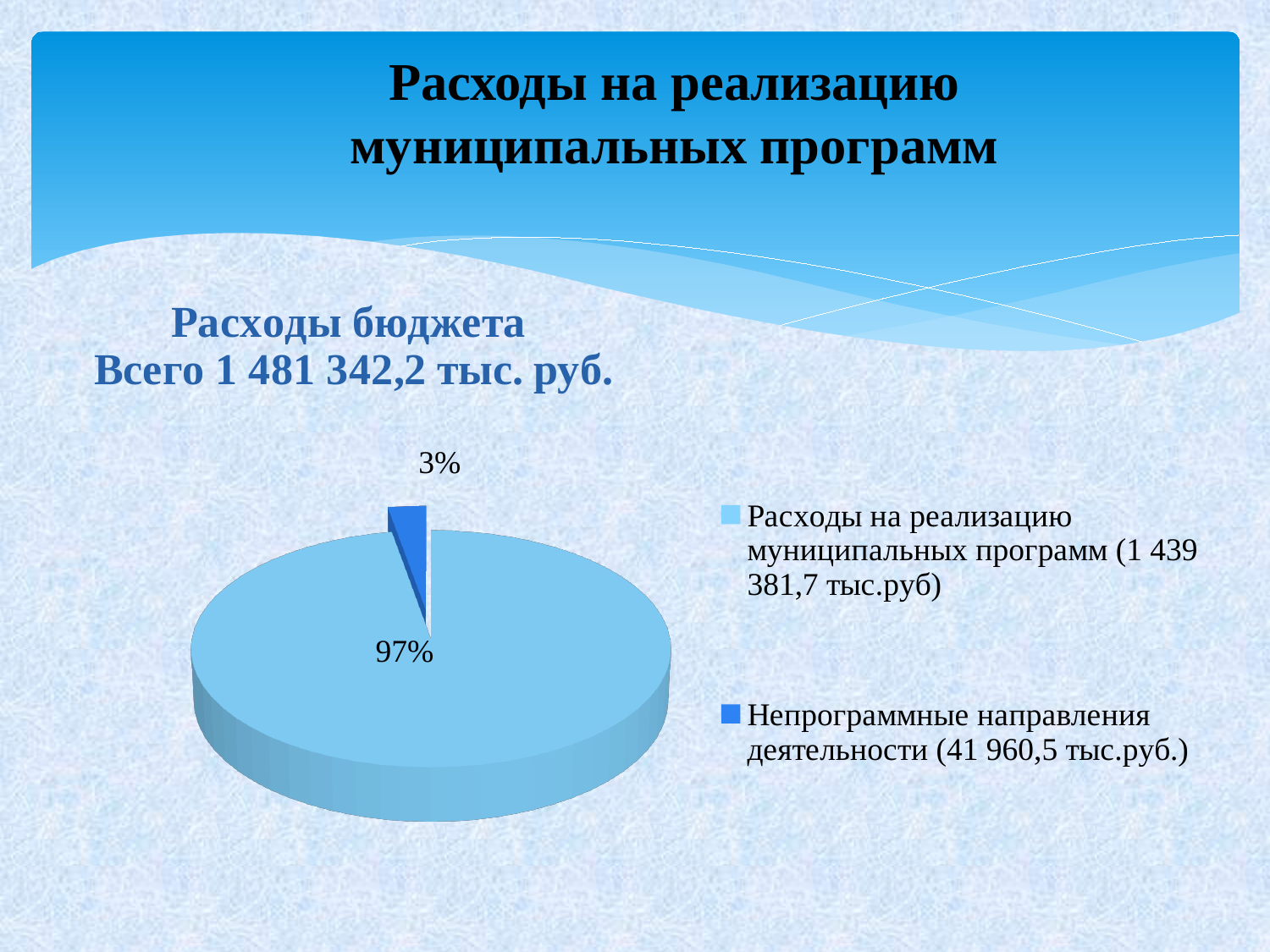
What share of the pie is labelled for "Расходы на реализацию муниципальных программ"? 97% What is the difference in percentage points between the 97% slice and the 3% slice? 94 percentage points What total budget expenditure is stated above the pie chart? 1 481 342,2 тыс. руб. What share of the pie is labelled for "Непрограммные направления деятельности"? 3% Which is larger: the share for "Расходы на реализацию муниципальных программ" or the share for "Непрограммные направления деятельности"? Расходы на реализацию муниципальных программ Which category has the smallest slice of the pie? Непрограммные направления деятельности What kind of chart is shown on the slide? pie chart How many entries does the legend of the pie chart list? 2 What amount is given in the legend for "Непрограммные направления деятельности"? 41 960,5 тыс.руб. How many slices does the pie chart have? 2 Which category has the largest slice of the pie? Расходы на реализацию муниципальных программ What amount is given in the legend for "Расходы на реализацию муниципальных программ"? 1 439 381,7 тыс.руб